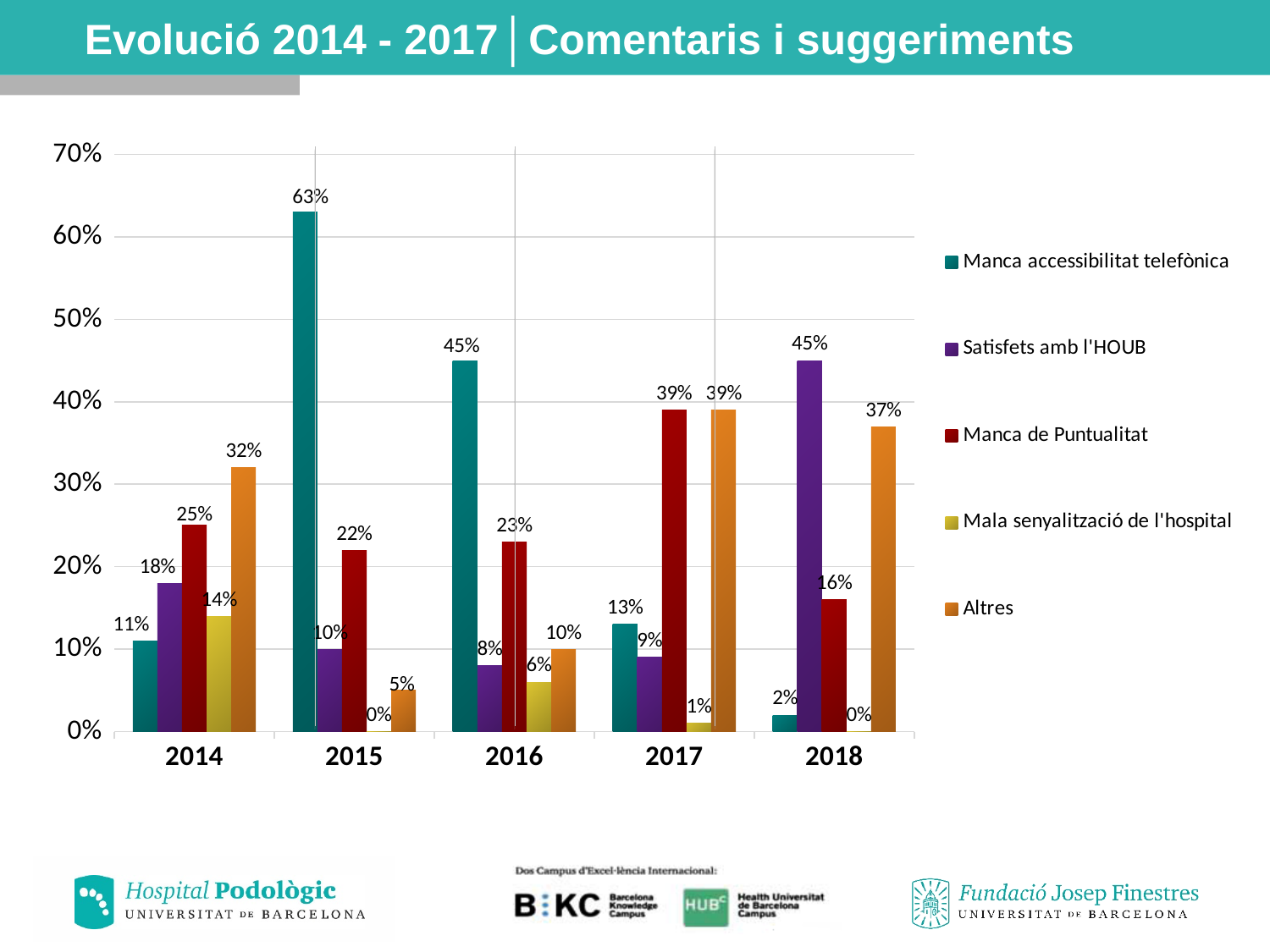
What kind of chart is shown on the slide? Bar chart What is the difference between Manca accessibilitat telefònica in 2015 and in 2016? 18% What is the value for Manca de Puntualitat in 2017? 39% In which year is Manca accessibilitat telefònica highest? 2015 How many series does the legend list? 5 What is the value for Manca accessibilitat telefònica in 2015? 63% What is the value for Satisfets amb l'HOUB in 2018? 45% How many years are shown on the x axis? 5 Which is larger in 2014: Manca de Puntualitat or Satisfets amb l'HOUB? Manca de Puntualitat What is the value for Altres in 2014? 32% In which year is Manca accessibilitat telefònica lowest? 2018 Does the value for Manca accessibilitat telefònica rise or fall from 2015 to 2018? Fall